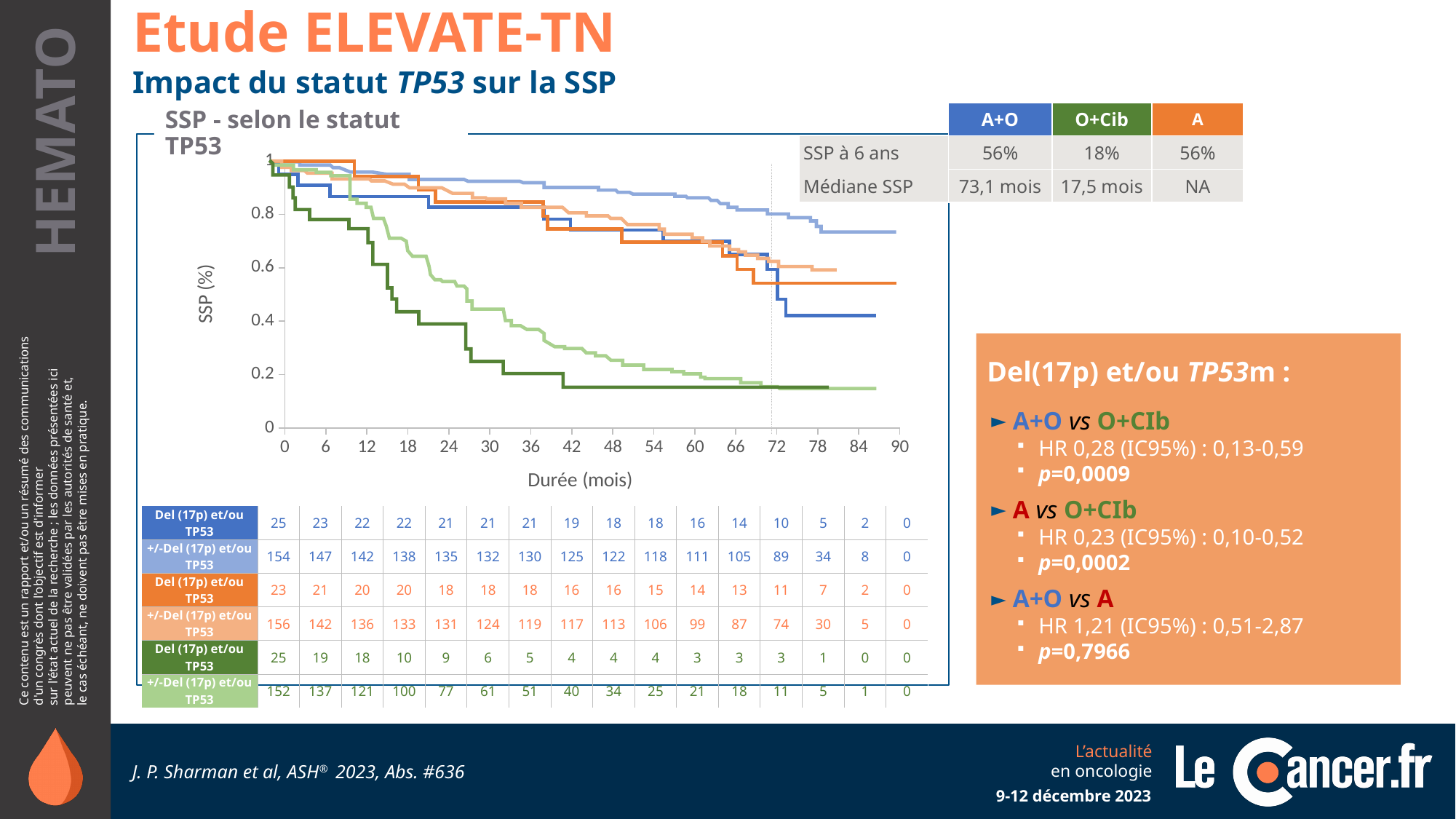
What is the difference in number at risk at 0 months between the light orange +/-Del (17p) et/ou TP53 row (156) and the light blue +/-Del (17p) et/ou TP53 row (154)? 2 What is the SSP à 6 ans for the O+Cib arm in the summary table? 18% Do the curves rise or fall along the x axis? fall In the number-at-risk table, how many patients are at risk at 0 months in the dark green Del (17p) et/ou TP53 row? 25 Which arm has the lowest SSP à 6 ans? O+Cib What is the Médiane SSP for the A arm? NA Is the value of the light blue curve at 48 months greater or less than 0.8? greater Is the value of the dark green curve at 30 months greater or less than 0.4? less In the number-at-risk table, how many patients are at risk at 36 months in the light green +/-Del (17p) et/ou TP53 row? 51 What kind of chart is shown on the slide? line chart What is the Médiane SSP for the A+O arm? 73,1 mois What is the label of the x axis? Durée (mois)